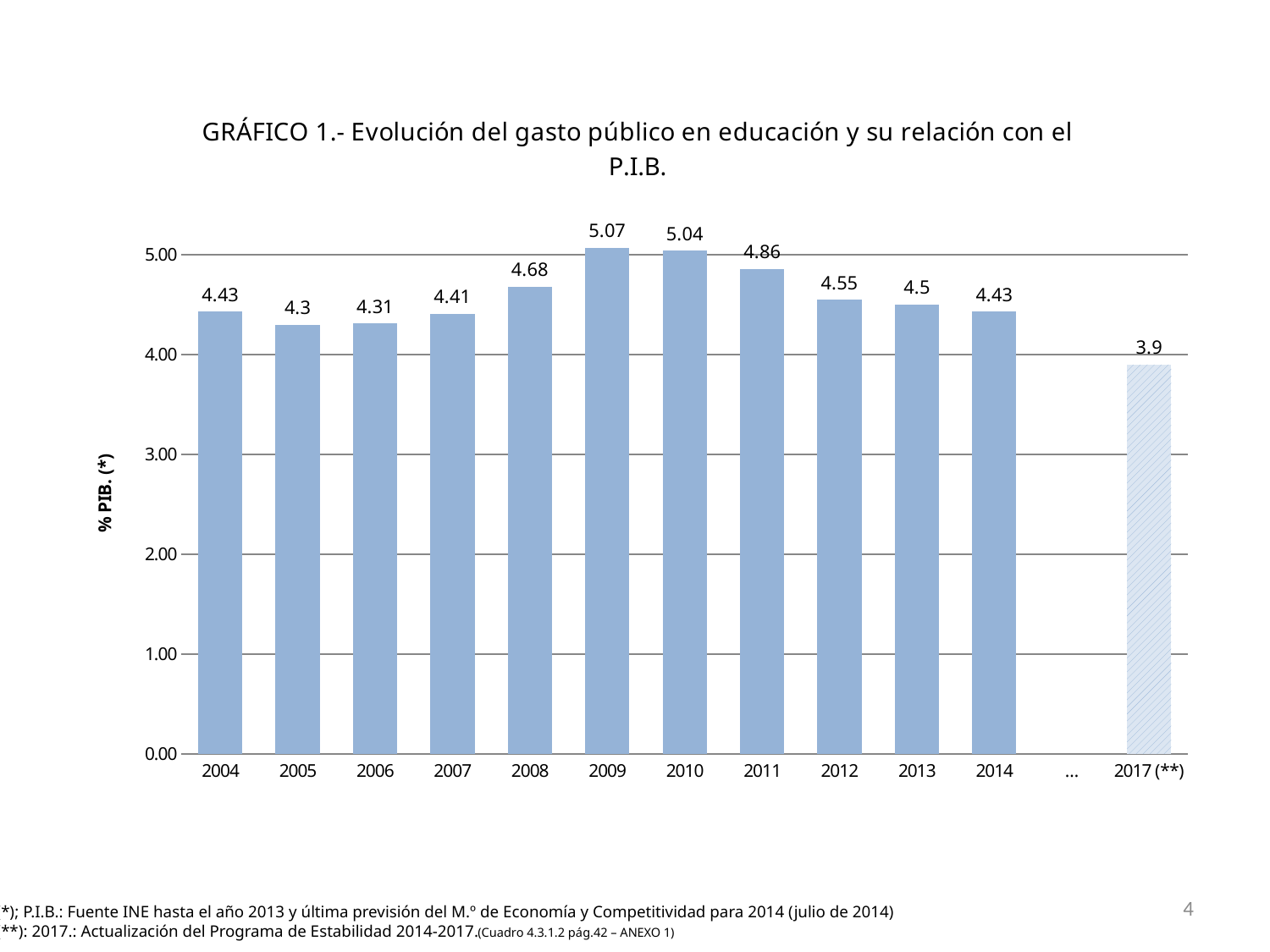
What type of chart is shown on the slide? bar chart Is the value for 2009 greater or less than 5.00? greater What is the value for 2017 (**)? 3.9 How many bars are plotted in the chart? 12 What is the difference between the values for 2009 and 2017 (**)? 1.17 Which is larger, the value for 2008 or the value for 2012? 2008 Which category has the lowest value? 2017 (**) What is the difference between the values for 2010 and 2011? 0.18 What is the value for 2009? 5.07 Do the values rise or fall from 2009 to 2014? fall Which year has the highest value? 2009 What is the value for 2005? 4.3